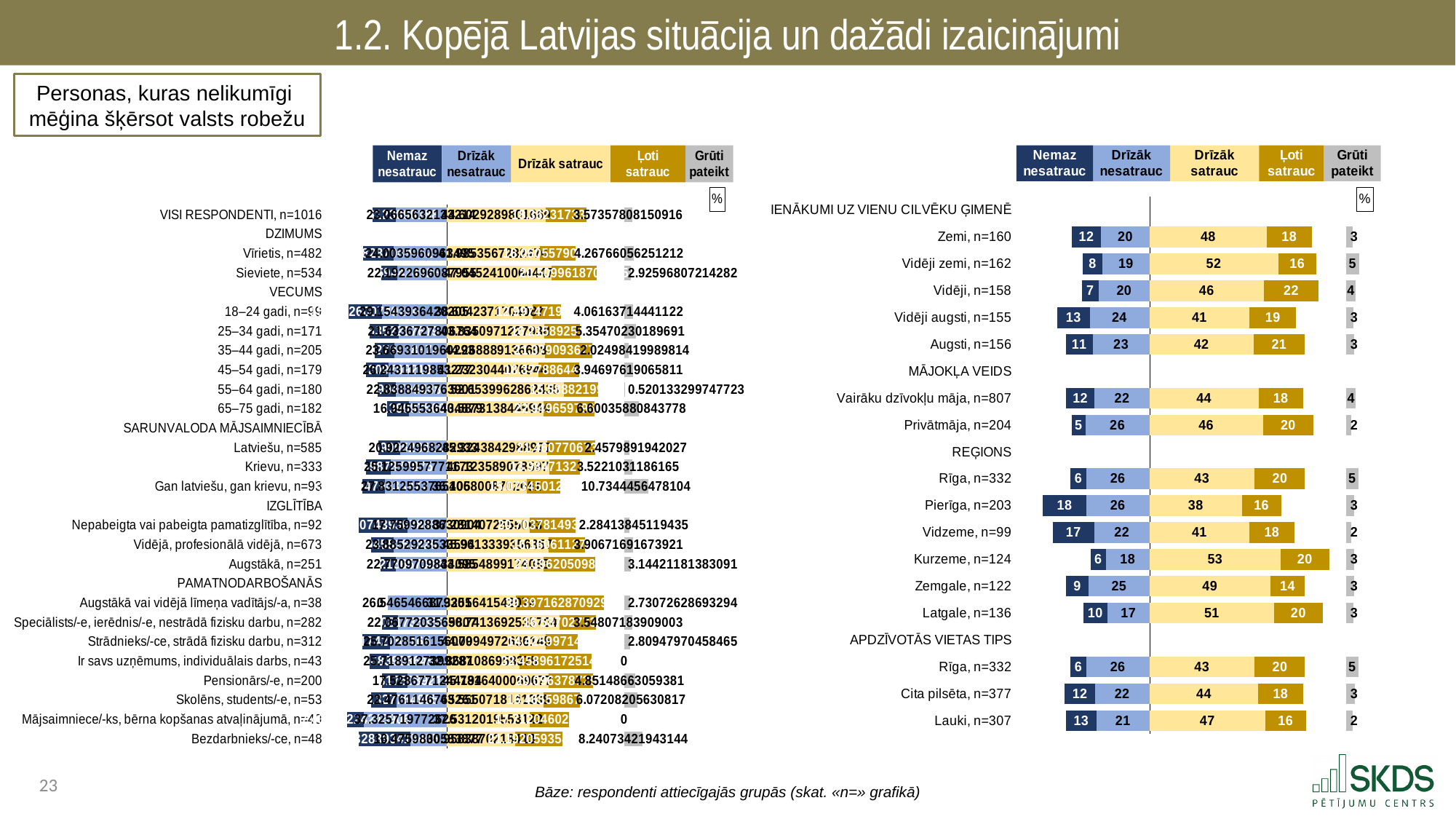
In the right chart, which region under REĢIONS has the lowest 'Ļoti satrauc' value? Zemgale, n=122 In the right chart, what is the difference between the 'Drīzāk satrauc' values for Latgale, n=136 and Pierīga, n=203? 13 In the right chart, what is the difference between the 'Drīzāk nesatrauc' values for Privātmāja, n=204 and Vairāku dzīvokļu māja, n=807? 4 In the right chart, what is the 'Drīzāk satrauc' value for Kurzeme, n=124? 53 In the right chart, what is the 'Grūti pateikt' value for Vidēji zemi, n=162? 5 In the right chart, which has a larger 'Nemaz nesatrauc' value: Lauki, n=307 or Rīga, n=332? Lauki, n=307 In the right chart, what is the 'Nemaz nesatrauc' value for Pierīga, n=203? 18 What kind of chart is the right chart? Stacked bar chart How many series does the legend of the right chart list? 5 In the right chart, how many regions are listed under REĢIONS? 6 In the right chart, which region under REĢIONS has the highest 'Drīzāk satrauc' value? Kurzeme, n=124 In the right chart, what is the 'Ļoti satrauc' value for Vidēji, n=158? 22